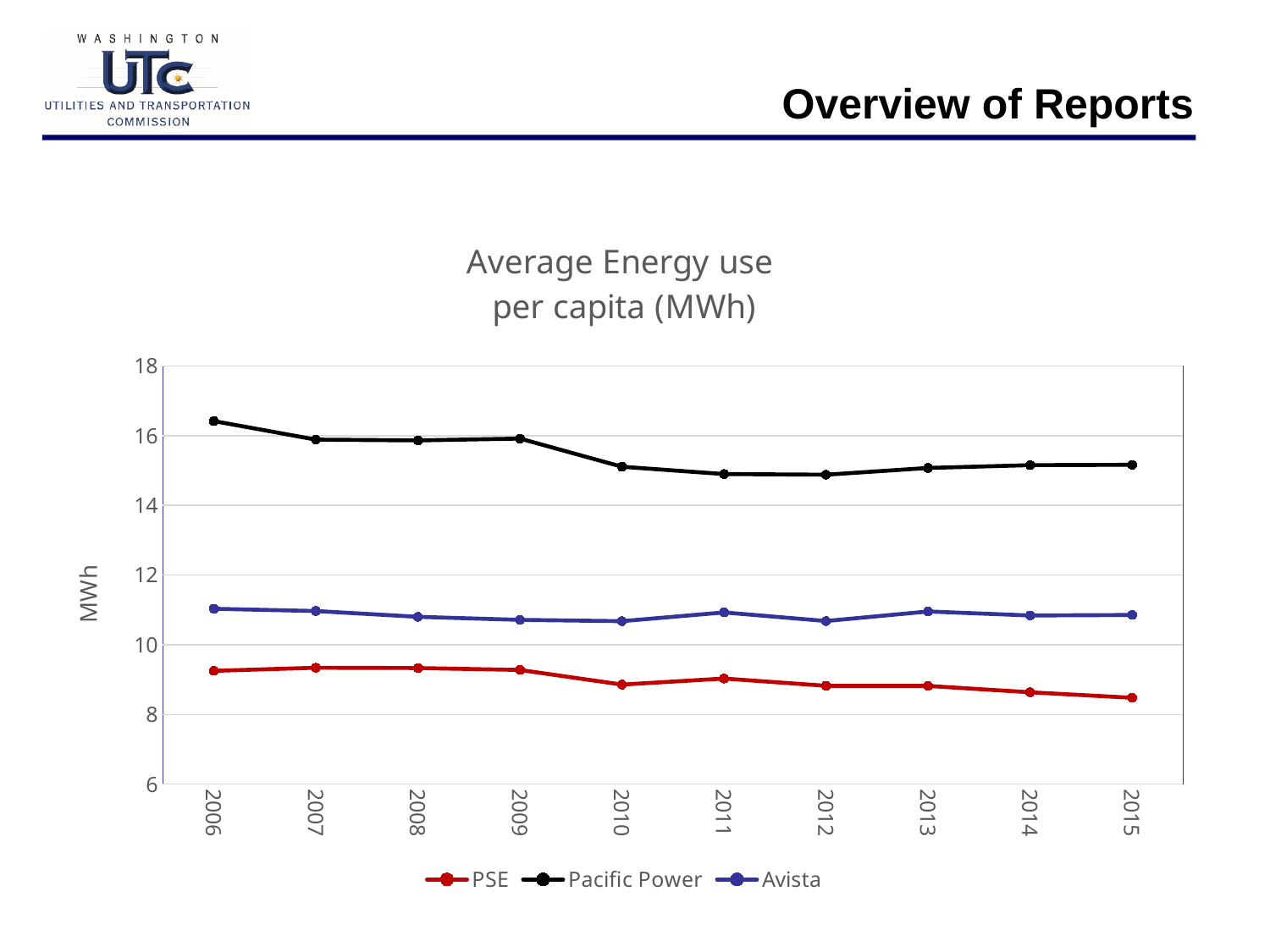
What kind of chart is shown on the slide? line chart Is the value for PSE in 2006 greater or less than 10? less What is the label on the y axis? MWh How many years are plotted along the x axis? 10 Is the value for Pacific Power in 2010 greater or less than 16? less In which year is the Pacific Power value highest? 2006 Is the value for Avista in 2006 greater or less than 10? greater Which series has the lowest average energy use per capita across all years? PSE Which is larger in 2015, the value for Avista or the value for PSE? Avista How many series does the legend list? 3 Which series has the highest average energy use per capita across all years? Pacific Power